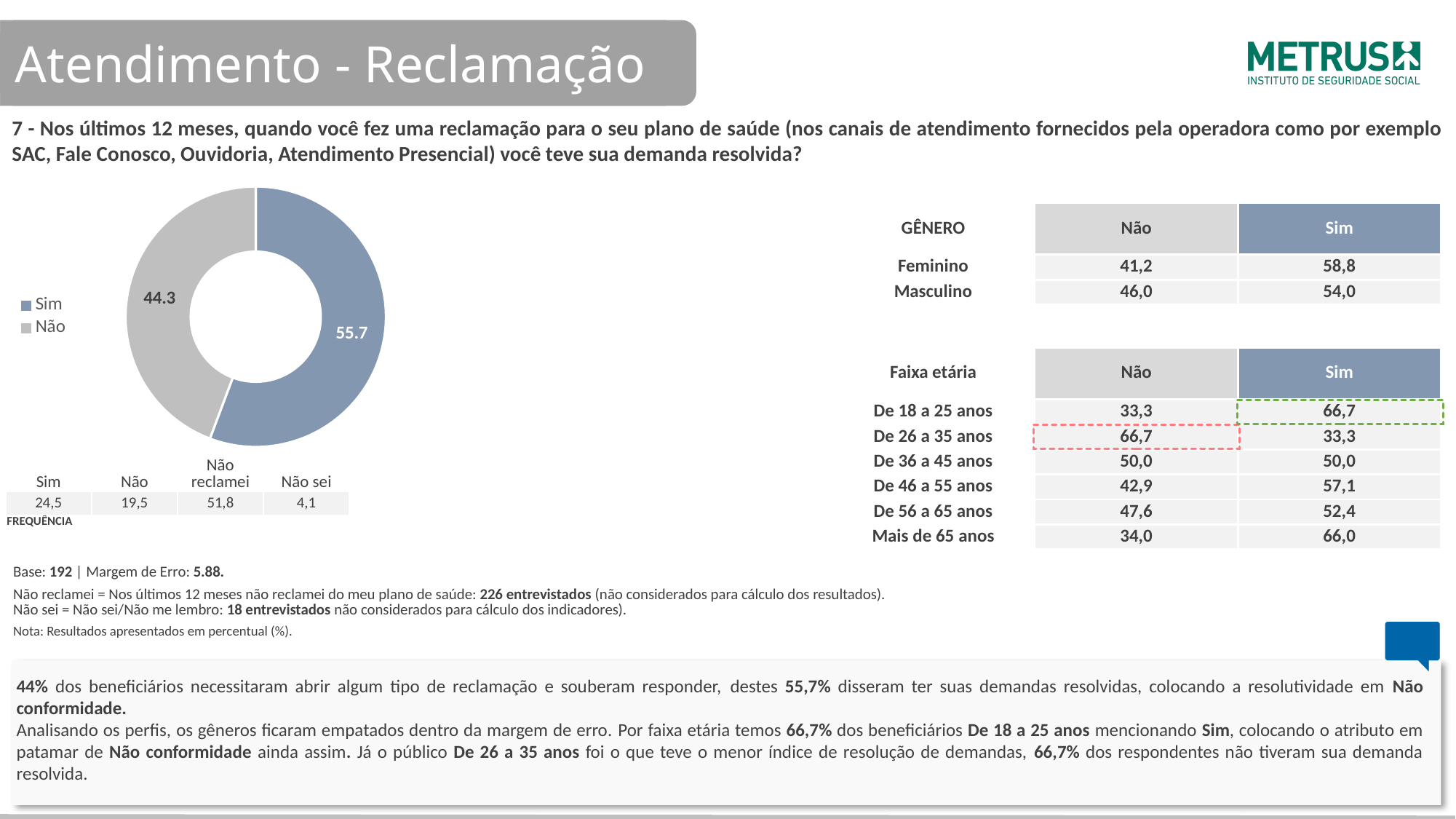
What is the value shown for the "Não" slice of the donut chart? 44.3 Is the value for "Sim" in the donut chart greater or less than 50? greater What is the value shown for the "Sim" slice of the donut chart? 55.7 What is the difference between the "Sim" and "Não" values in the donut chart? 11.4 What colour is the "Não" slice in the donut chart? Grey How many slices does the donut chart have? 2 What kind of chart is shown on the slide? Pie chart (donut) Which slice of the donut chart is the smallest? Não What are the two legend entries of the donut chart? Sim and Não How many entries does the legend of the donut chart list? 2 In the donut chart, which is larger, "Sim" or "Não"? Sim Which slice of the donut chart is the largest? Sim